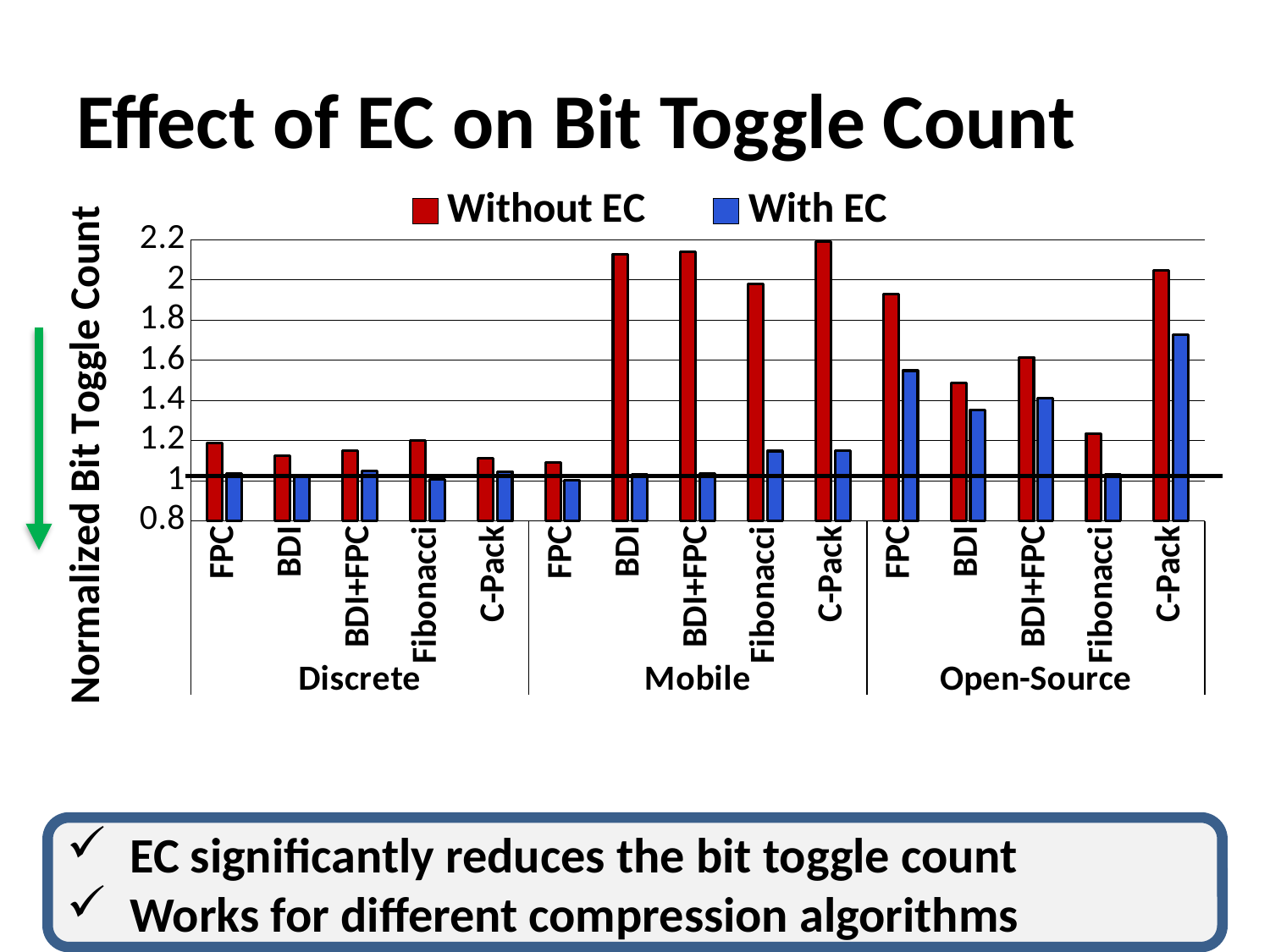
What are the two series named in the legend? Without EC and With EC Which has the larger With EC value: C-Pack in the Mobile group or C-Pack in the Open-Source group? C-Pack in the Open-Source group Which category has the highest With EC value? C-Pack in the Open-Source group How many compression algorithm categories are plotted in total across all groups? 15 Is the Without EC value for BDI in the Mobile group greater or less than 2? greater How many application groups are shown along the x axis? 3 Is the With EC value for FPC in the Open-Source group greater or less than 1.4? greater In the Open-Source group, which has the larger Without EC value: FPC or BDI? FPC How many series does the legend list? 2 Is the With EC value for BDI in the Open-Source group greater or less than 1.4? less What kind of chart is shown on the slide? Bar chart